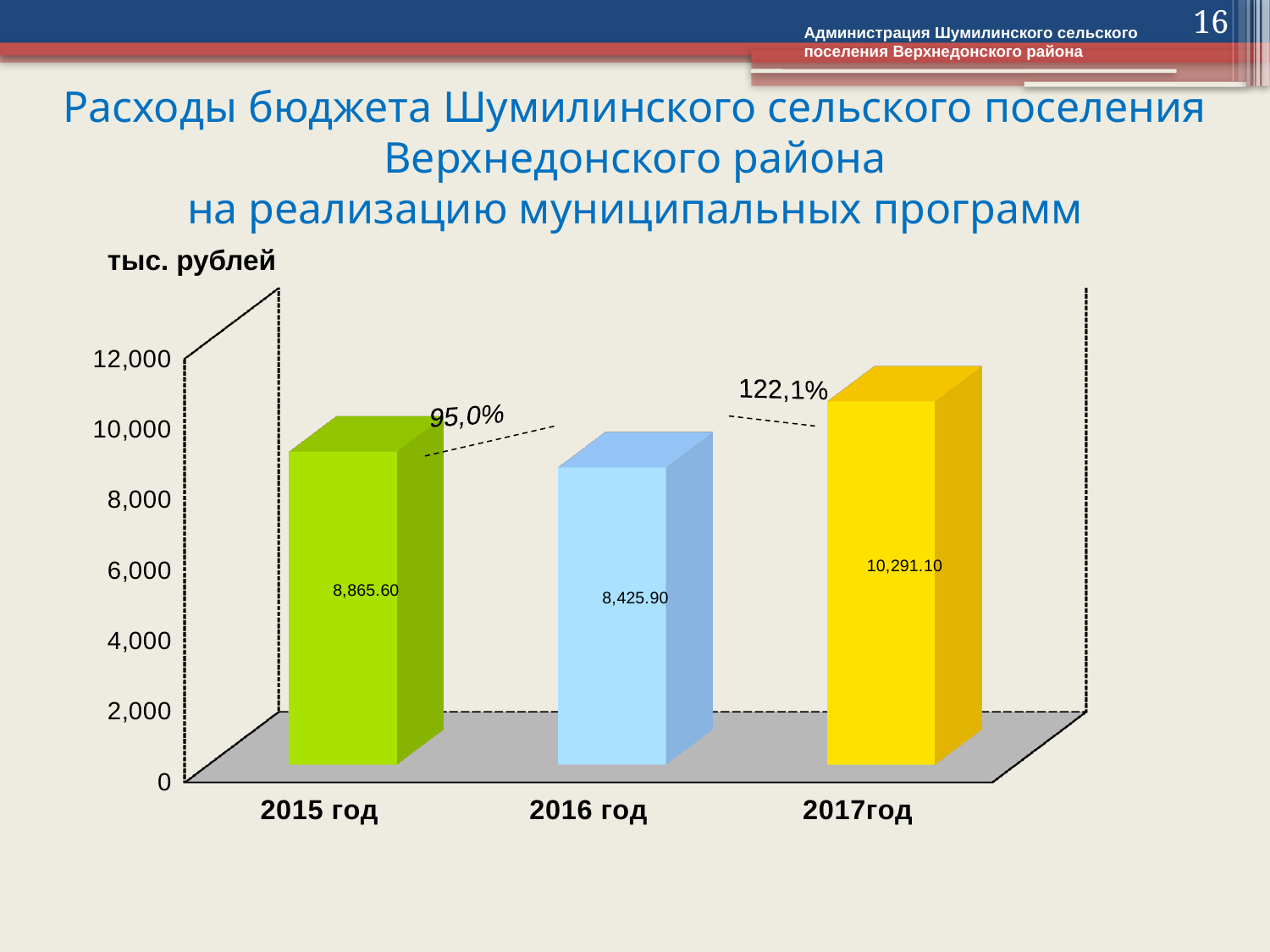
What is the value for 2015 год? 8,865.60 Is the value for 2017год greater or less than 10,000? greater What is the value for 2016 год? 8,425.90 What is the value for 2017год? 10,291.10 What kind of chart is shown on the slide? bar chart What is the difference between the values for 2017год and 2016 год? 1,865.20 Which year has the highest value? 2017год Which is larger, the value for 2015 год or the value for 2016 год? 2015 год How many years are shown on the chart? 3 Which year has the lowest value? 2016 год What is the difference between the values for 2015 год and 2016 год? 439.70 What unit is indicated above the chart's vertical axis? тыс. рублей